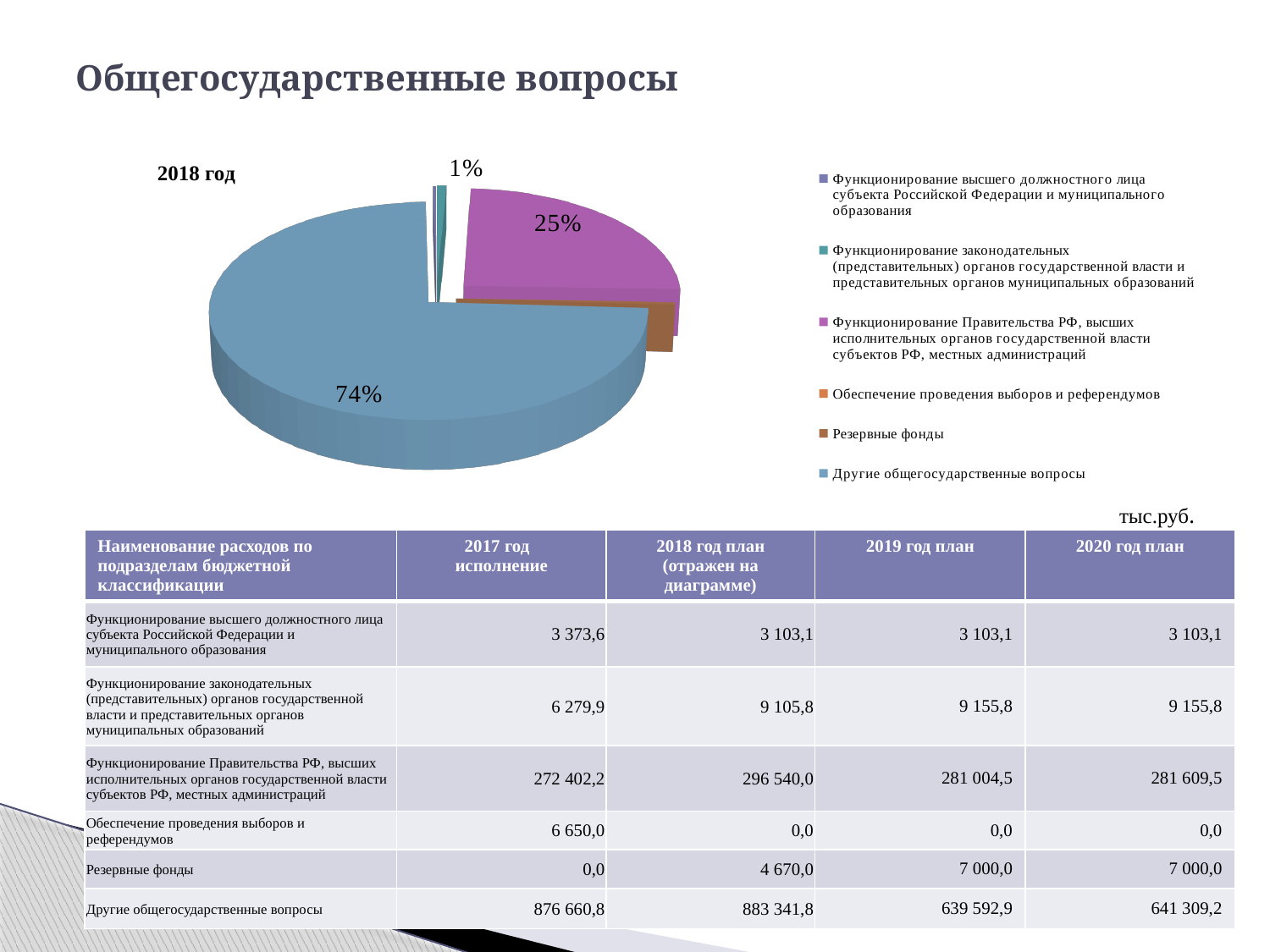
What percentage does the pie chart show for Другие общегосударственные вопросы? 74% Which slice is larger: Другие общегосударственные вопросы or Функционирование Правительства РФ, высших исполнительных органов государственной власти субъектов РФ, местных администраций? Другие общегосударственные вопросы How many percentage labels are printed on the pie chart? 3 How many entries does the legend of the pie chart list? 6 Which category has the largest slice in the pie chart? Другие общегосударственные вопросы What kind of chart is shown on the slide? Pie chart What is the smallest percentage label shown on the pie chart? 1% What colour is the largest slice of the pie chart? Light blue Which year is the pie chart labelled with? 2018 год What percentage does the pie chart show for Функционирование Правительства РФ, высших исполнительных органов государственной власти субъектов РФ, местных администраций? 25% By how many percentage points does the Другие общегосударственные вопросы slice exceed the Функционирование Правительства РФ slice? 49 percentage points